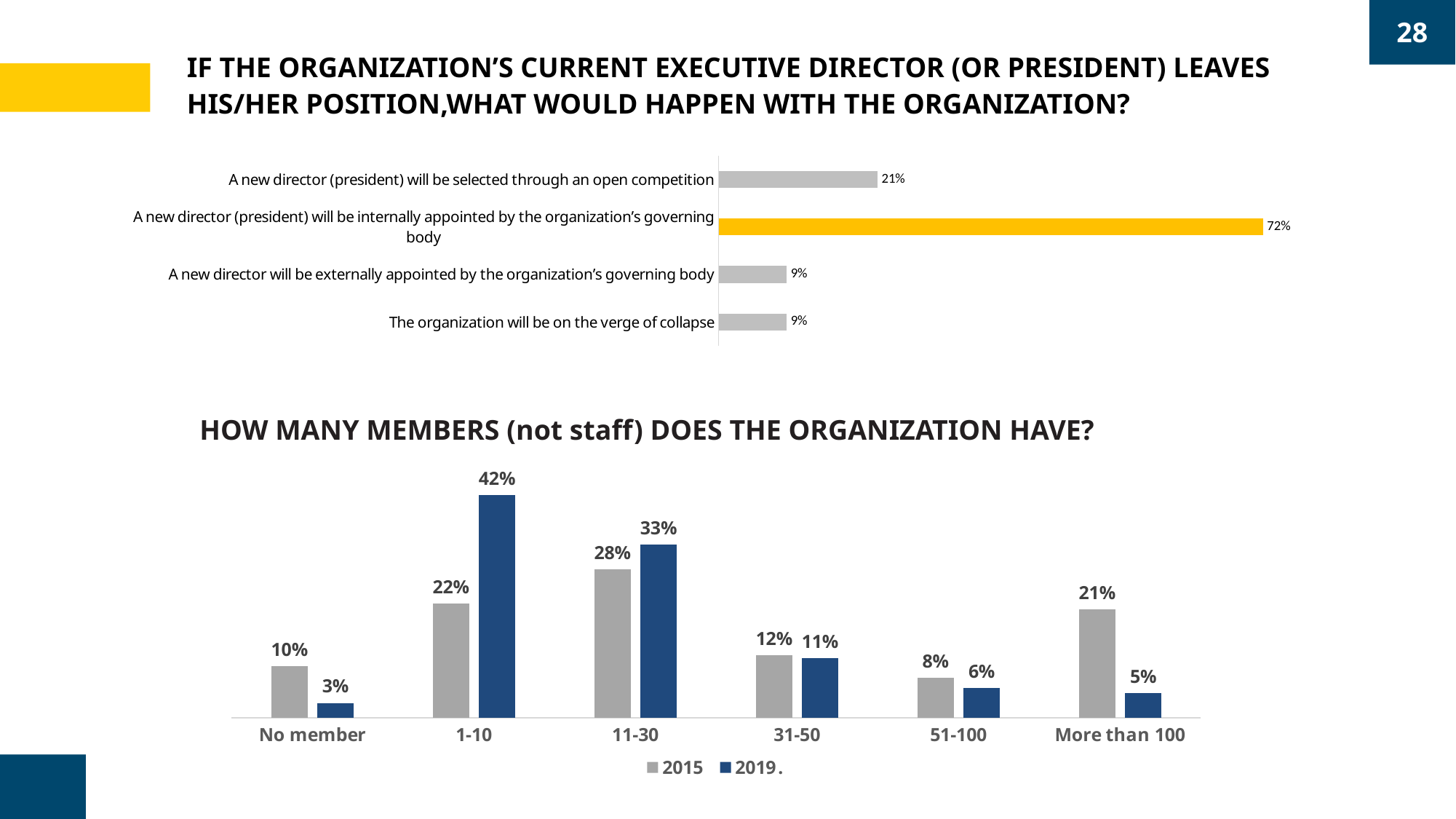
In the top chart about what would happen if the executive director leaves, what percentage says a new director will be selected through an open competition? 21% In the bottom chart 'How many members (not staff) does the organization have?', what is the 2015 value for More than 100 members? 21% In the bottom chart 'How many members (not staff) does the organization have?', what is the difference between the 2015 and 2019 values for No member? 7% In the bottom chart 'How many members (not staff) does the organization have?', which category has the lowest 2019 value? No member In the top chart about what would happen if the executive director leaves, which option has the highest value? A new director (president) will be internally appointed by the organization's governing body In the bottom chart 'How many members (not staff) does the organization have?', what is the 2019 value for 1-10 members? 42% In the bottom chart 'How many members (not staff) does the organization have?', how many series does the legend list? 2 In the top chart about what would happen if the executive director leaves, what percentage says a new director will be internally appointed by the organization's governing body? 72% In the top chart about what would happen if the executive director leaves, how many response options are shown? 4 In the bottom chart 'How many members (not staff) does the organization have?', which is larger for 11-30 members: the 2015 value or the 2019 value? 2019 What type of chart is the bottom chart 'How many members (not staff) does the organization have?' Bar chart In the top chart about what would happen if the executive director leaves, what is the difference between the internally appointed option and the open competition option? 51%